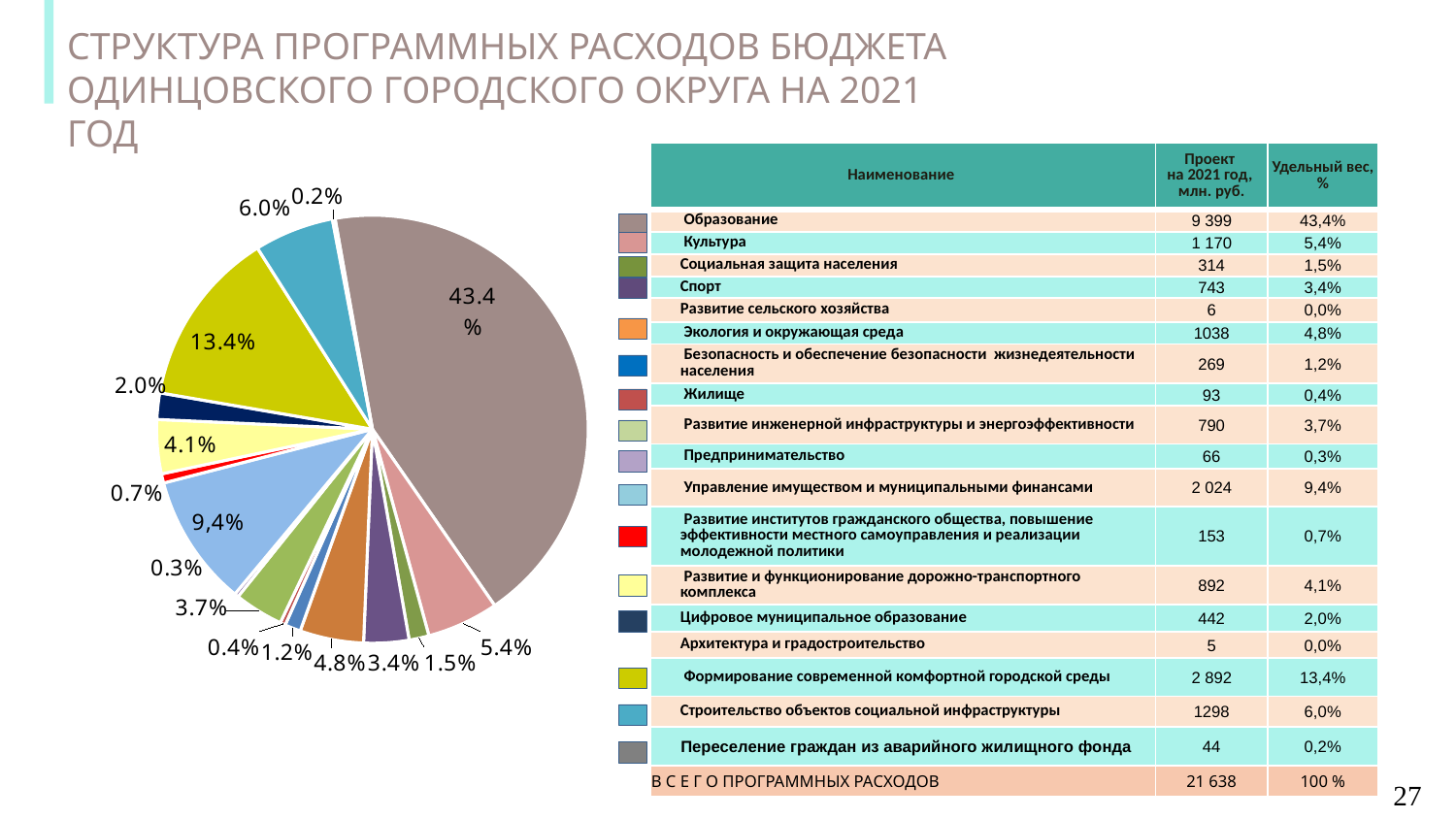
What is the largest slice of the pie chart? 43.4% What is the share of the pie for Строительство объектов социальной инфраструктуры? 6.0% What share of the pie does the yellow-green slice (Формирование современной комфортной городской среды) represent? 13.4% Which is larger in the pie chart: the 6.0% slice or the 5.4% slice? 6.0% What is the title of the slide containing the pie chart? СТРУКТУРА ПРОГРАММНЫХ РАСХОДОВ БЮДЖЕТА ОДИНЦОВСКОГО ГОРОДСКОГО ОКРУГА НА 2021 ГОД What is the difference between the 43.4% slice and the 13.4% slice in the pie chart? 30 percentage points What is the share of the pie for Цифровое муниципальное образование? 2.0% What kind of chart is shown on the slide? pie chart Which category does the largest slice of the pie chart (43.4%) correspond to, according to the table? Образование What is the smallest labelled slice of the pie chart? 0.2% How many slices are labelled on the pie chart? 16